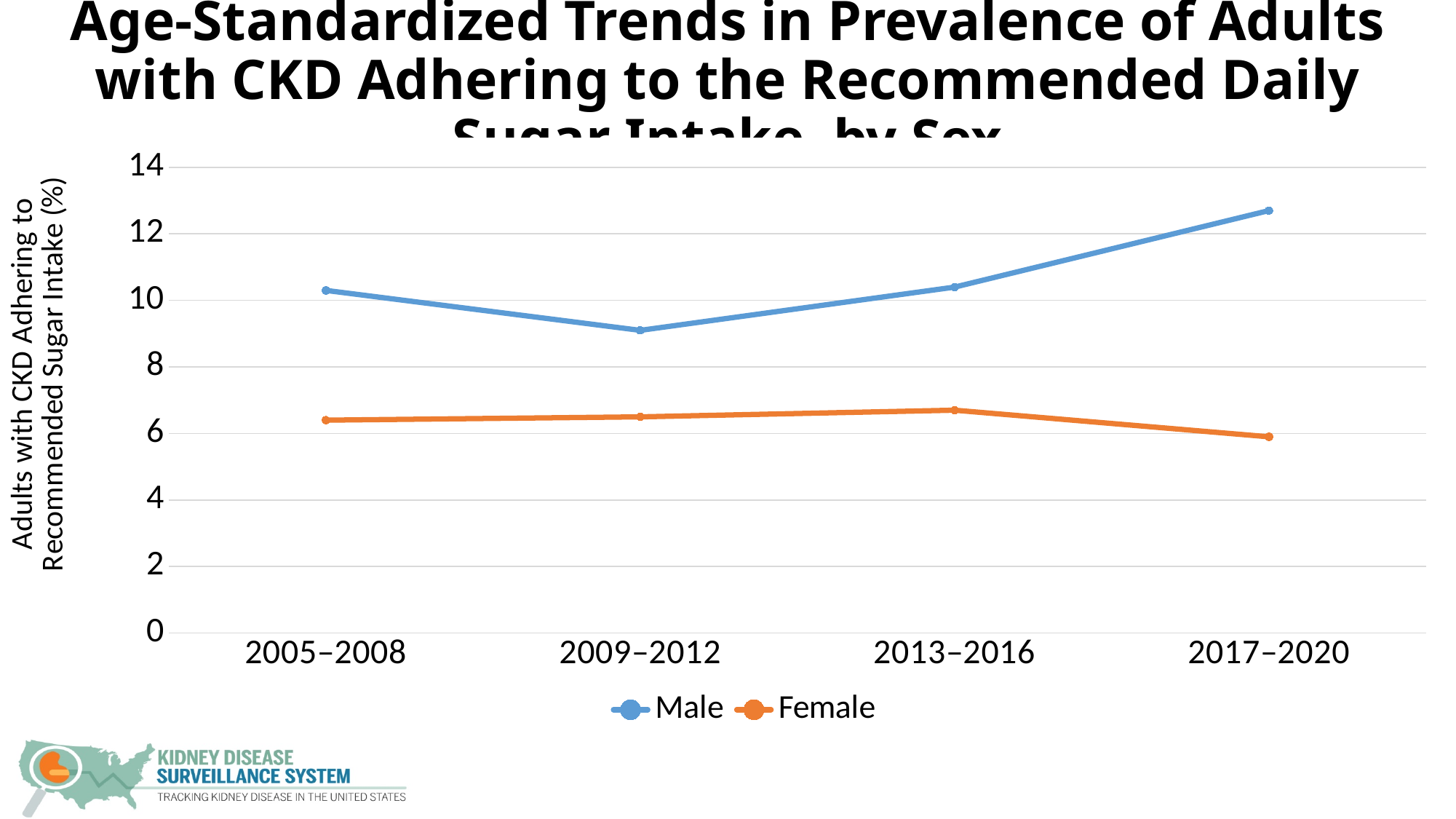
Is the Female value for 2013–2016 greater or less than 6? greater What is the label on the y axis? Adults with CKD Adhering to Recommended Sugar Intake (%) In which period is the Female value lowest? 2017–2020 Is the Male value for 2009–2012 greater or less than 10? less How many series does the legend list? 2 Is the Male value for 2017–2020 greater or less than 12? greater In which period is the Male value highest? 2017–2020 Does the Male line rise or fall from 2009–2012 to 2017–2020? rise How many time periods are shown on the x axis? 4 Which series has the larger value in 2017–2020, Male or Female? Male What kind of chart is shown on the slide? line chart In which period is the Male value lowest? 2009–2012